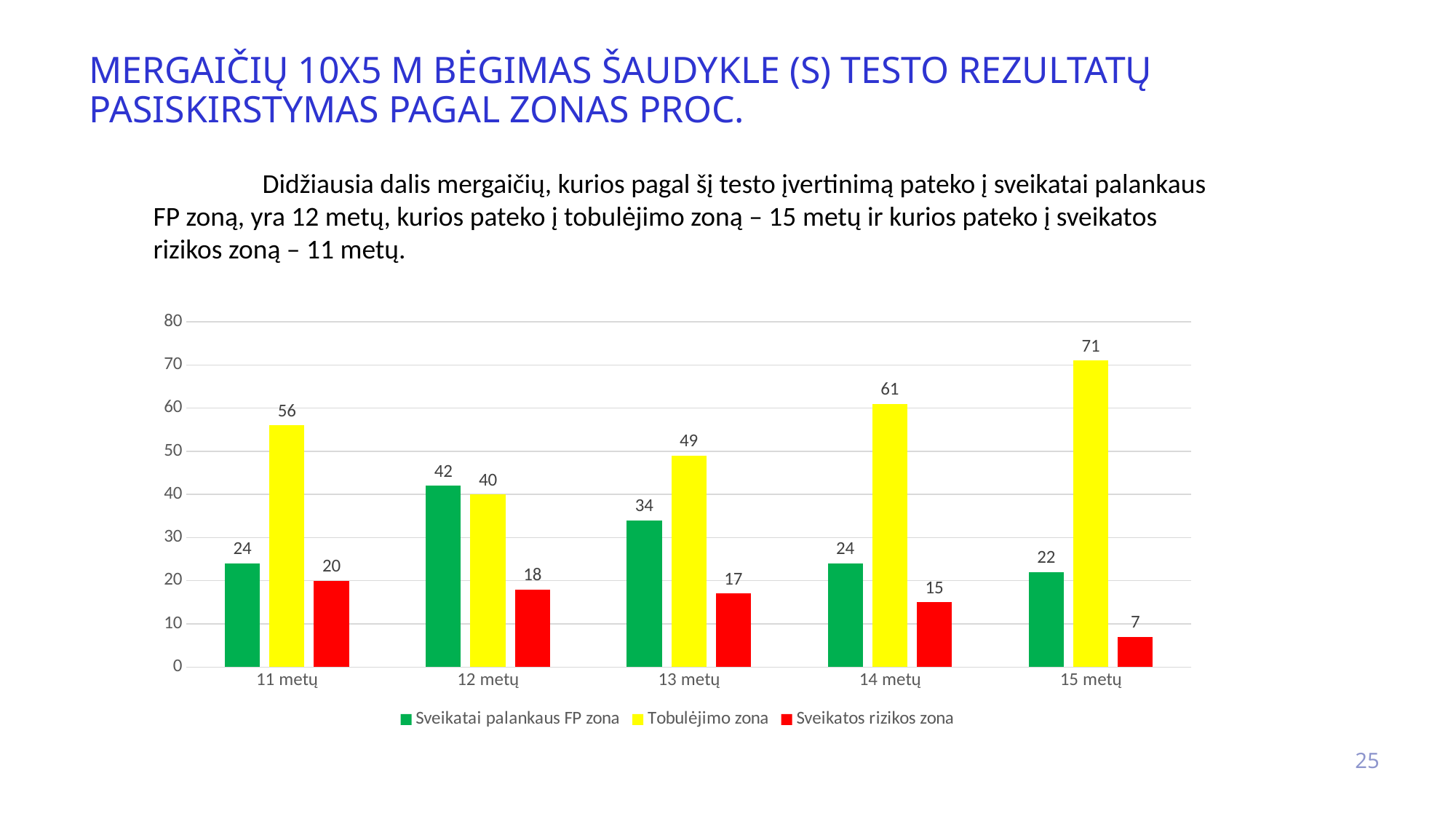
What is the value for Sveikatai palankaus FP zona at 12 metų? 42 What kind of chart is shown on the slide? Bar chart How many series does the legend list? 3 Do the values for Sveikatos rizikos zona rise or fall from 11 metų to 15 metų? Fall Which age group has the lowest value for Sveikatos rizikos zona? 15 metų What is the value for Tobulėjimo zona at 15 metų? 71 What is the difference between the Tobulėjimo zona value and the Sveikatai palankaus FP zona value at 14 metų? 37 What is the value for Sveikatos rizikos zona at 13 metų? 17 Which is larger at 12 metų: Sveikatai palankaus FP zona or Tobulėjimo zona? Sveikatai palankaus FP zona How many age groups are shown on the x axis? 5 Which age group has the highest value for Tobulėjimo zona? 15 metų What colour represents Tobulėjimo zona in the chart? Yellow